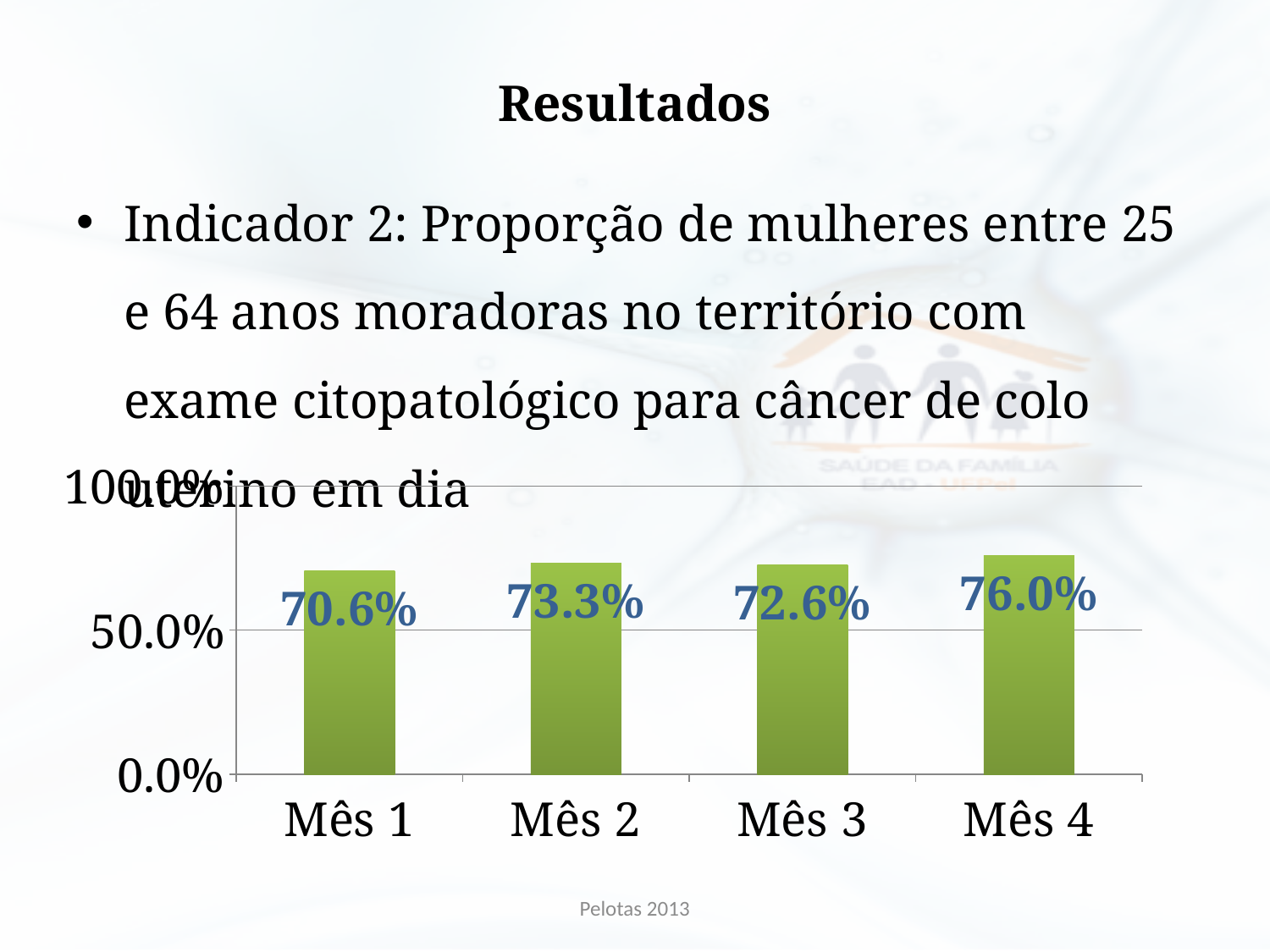
Which month has the lowest value? Mês 1 What is the difference between the values for Mês 4 and Mês 1? 5.4% Is the value for Mês 4 greater or less than 50.0%? greater What is the value for Mês 4? 76.0% What is the value for Mês 1? 70.6% What kind of chart is shown on the slide? bar chart How many months are shown on the x axis? 4 Which month has the highest value? Mês 4 What is the value for Mês 2? 73.3% What is the value for Mês 3? 72.6% Which is larger, the value for Mês 2 or the value for Mês 3? Mês 2 What is the difference between the values for Mês 2 and Mês 3? 0.7%